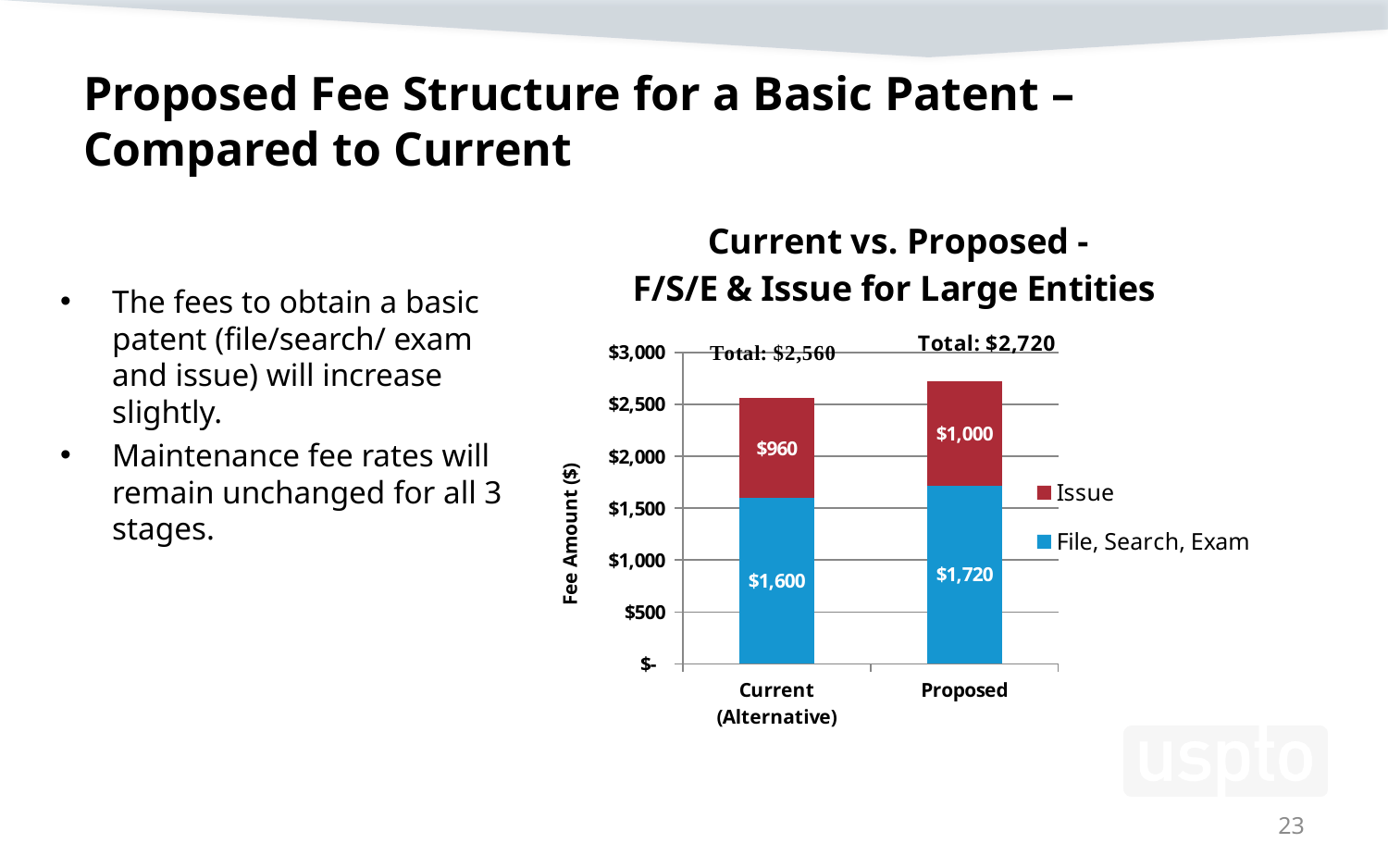
What is the Issue fee for the Current (Alternative) category? $960 What is the difference between the File, Search, Exam fee for Proposed and for Current (Alternative)? $120 What is the total fee shown for the Proposed bar? $2,720 What is the File, Search, Exam fee for the Current (Alternative) category? $1,600 Which category has the higher Issue fee, Current (Alternative) or Proposed? Proposed What is the File, Search, Exam fee for the Proposed category? $1,720 How many series does the legend list? 2 What is the Issue fee for the Proposed category? $1,000 What kind of chart is shown on the slide? Stacked bar chart What is the title of the chart? Current vs. Proposed - F/S/E & Issue for Large Entities What is the total fee shown for the Current (Alternative) bar? $2,560 What is the difference between the Proposed total and the Current (Alternative) total? $160